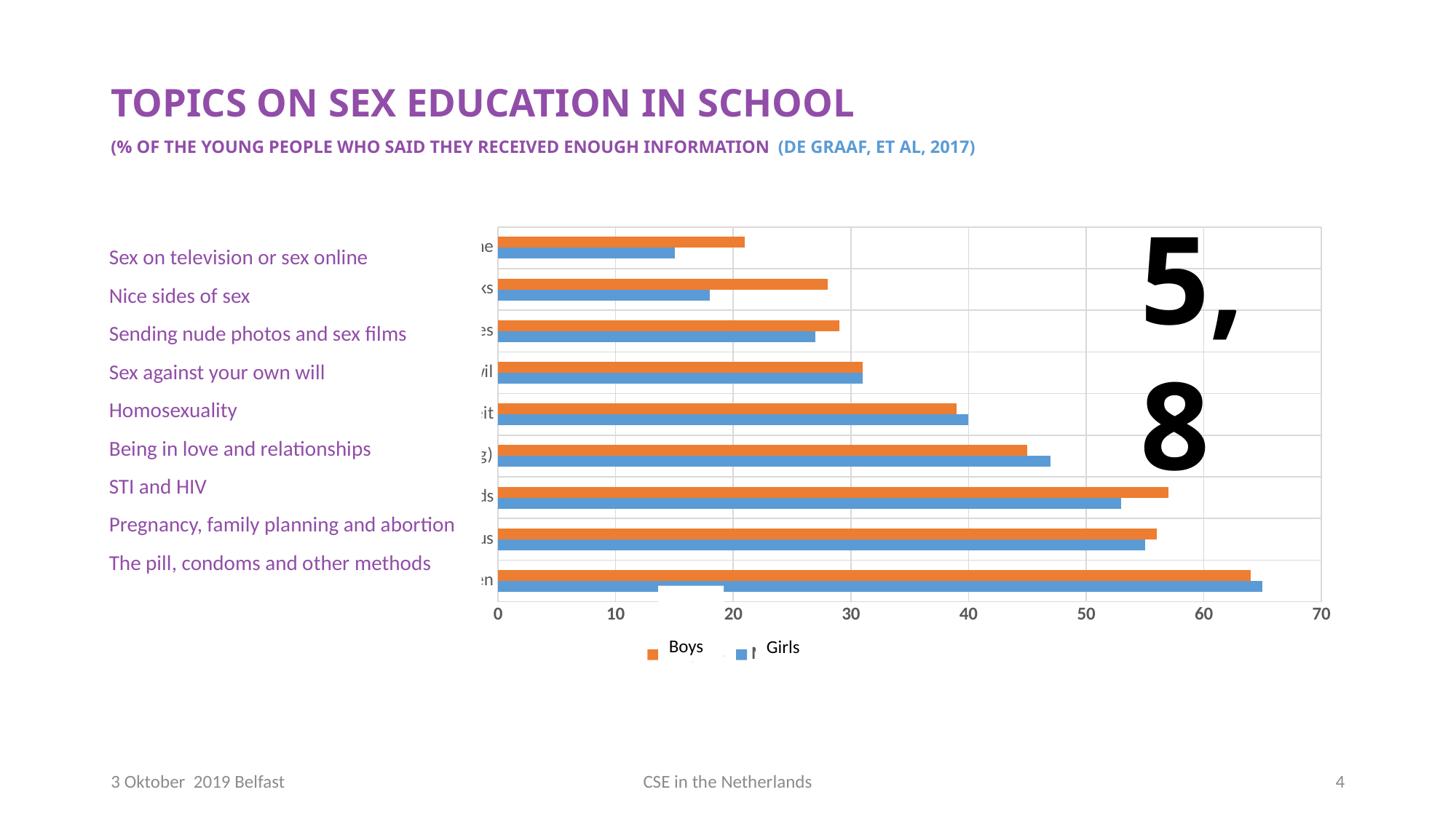
Is the Boys value for 'Nice sides of sex' greater or less than 20? greater Which topic has the lowest Girls value? Sex on television or sex online Is the Boys value for 'STI and HIV' greater or less than 50? greater Which topic has the highest Girls value? The pill, condoms and other methods For 'Sex on television or sex online', which is larger, the Boys value or the Girls value? Boys Which colour represents the Boys series in the chart? orange How many topic categories are plotted in the chart? 9 How many series does the chart's legend list? 2 What are the two series named in the chart's legend? Boys and Girls What kind of chart is shown on the slide? bar chart Is the Girls value for 'Sex on television or sex online' greater or less than 20? less